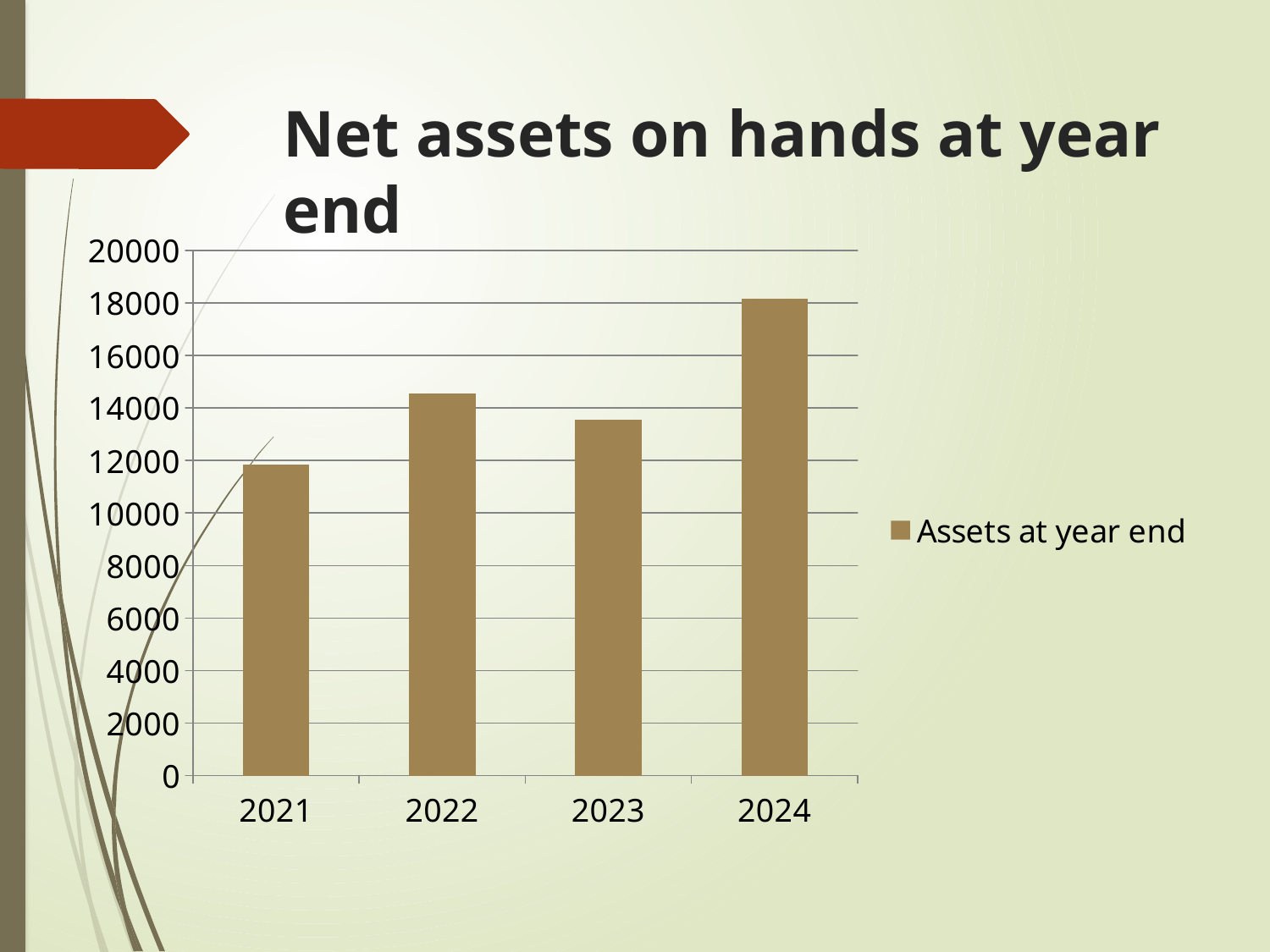
What is the name of the series shown in the legend? Assets at year end How many years are shown on the x axis? 4 Which year has the lowest assets at year end? 2021 Does the value rise or fall from 2022 to 2023? fall Is the value for 2021 greater or less than 10000? greater Is the value for 2024 greater or less than 16000? greater Which year has the highest assets at year end? 2024 Is the value for 2023 greater or less than 14000? less How many series does the legend list? 1 Which year has the larger value, 2022 or 2023? 2022 What kind of chart is shown on the slide? bar chart What is the title of the chart? Net assets on hands at year end